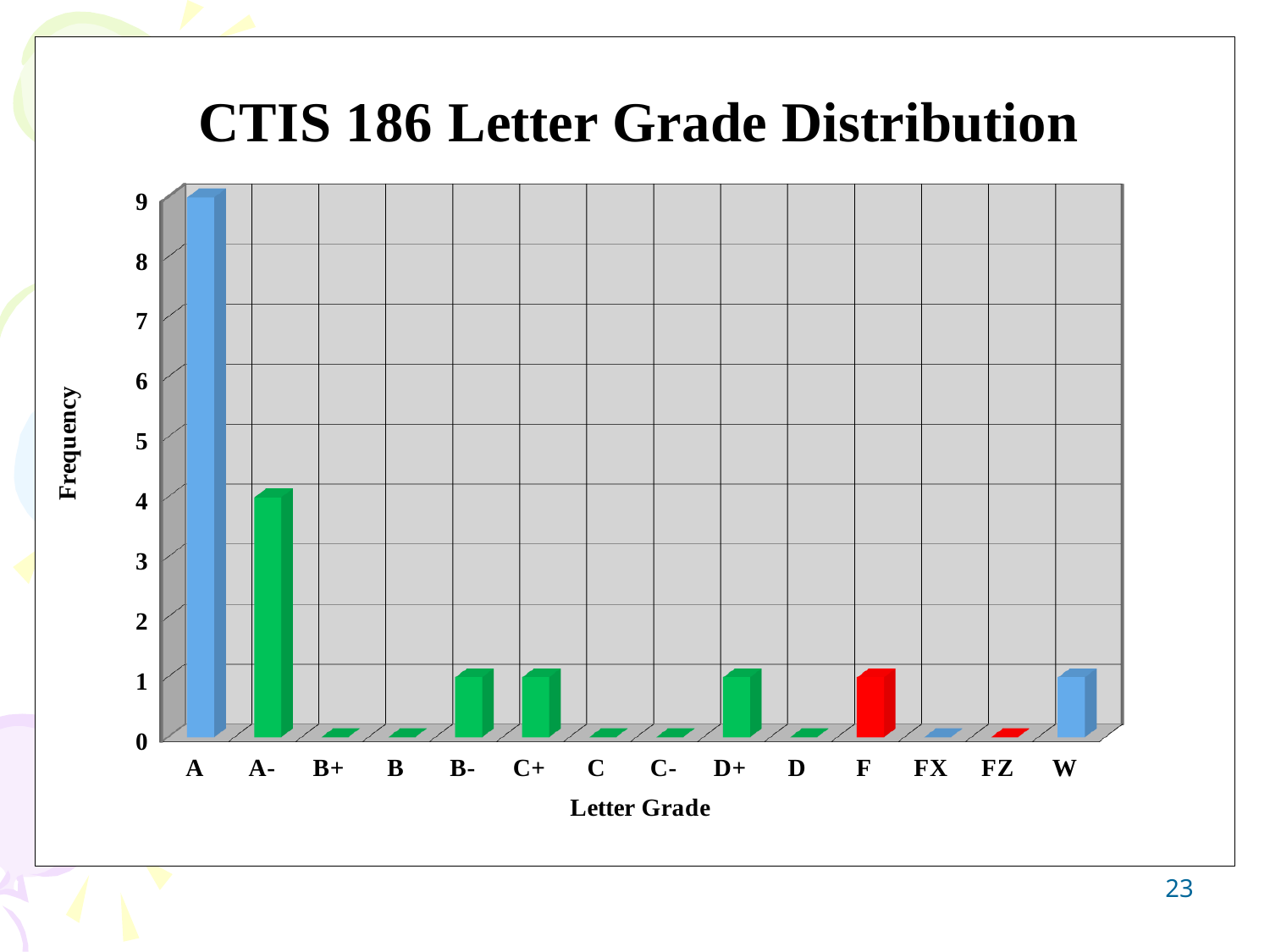
What is the difference in frequency between grade A and grade A-? 5 What is the frequency for letter grade A-? 4 How many letter grade categories are shown on the x axis? 14 What is the title of the chart? CTIS 186 Letter Grade Distribution What kind of chart is shown on the slide? bar chart What is the frequency for letter grade B-? 1 Which letter grade has the highest frequency? A What is the label of the vertical axis? Frequency Is the frequency for grade A greater or less than 5? greater What is the frequency for letter grade A? 9 What is the frequency for letter grade B+? 0 Which has a higher frequency, grade A- or grade F? A-